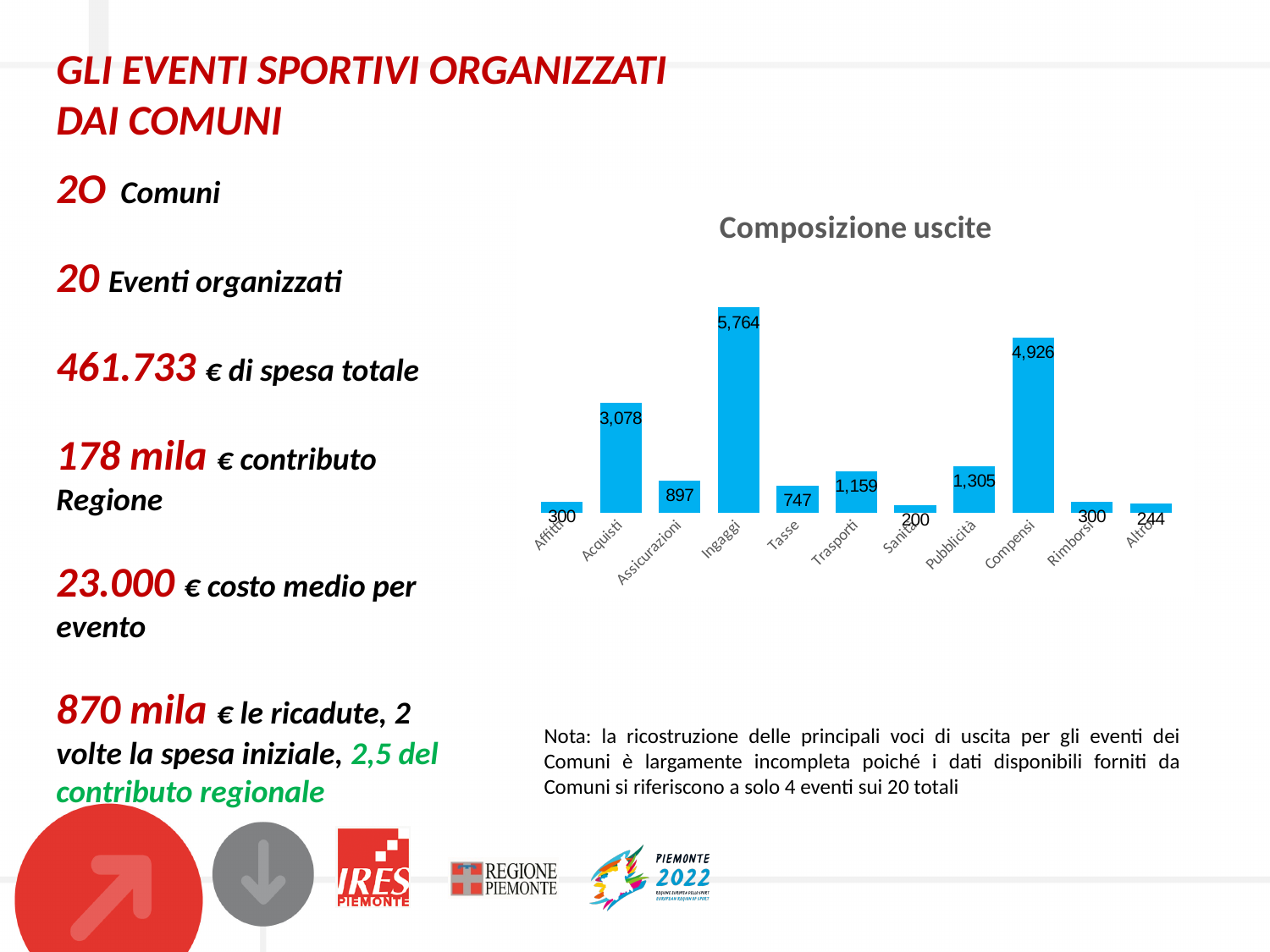
What is the value for Assicurazioni in the Composizione uscite chart? 897 Which is larger in the Composizione uscite chart, Trasporti or Tasse? Trasporti What is the value for Compensi in the Composizione uscite chart? 4,926 What is the title of the chart on the slide? Composizione uscite How many categories are shown in the Composizione uscite chart? 11 What kind of chart is the Composizione uscite chart? Bar chart What is the value for Ingaggi in the Composizione uscite chart? 5,764 Which category has the highest value in the Composizione uscite chart? Ingaggi Which category has the lowest value in the Composizione uscite chart? Sanità What is the difference between Ingaggi and Compensi in the Composizione uscite chart? 838 What is the value for Pubblicità in the Composizione uscite chart? 1,305 What is the difference between Acquisti and Assicurazioni in the Composizione uscite chart? 2,181